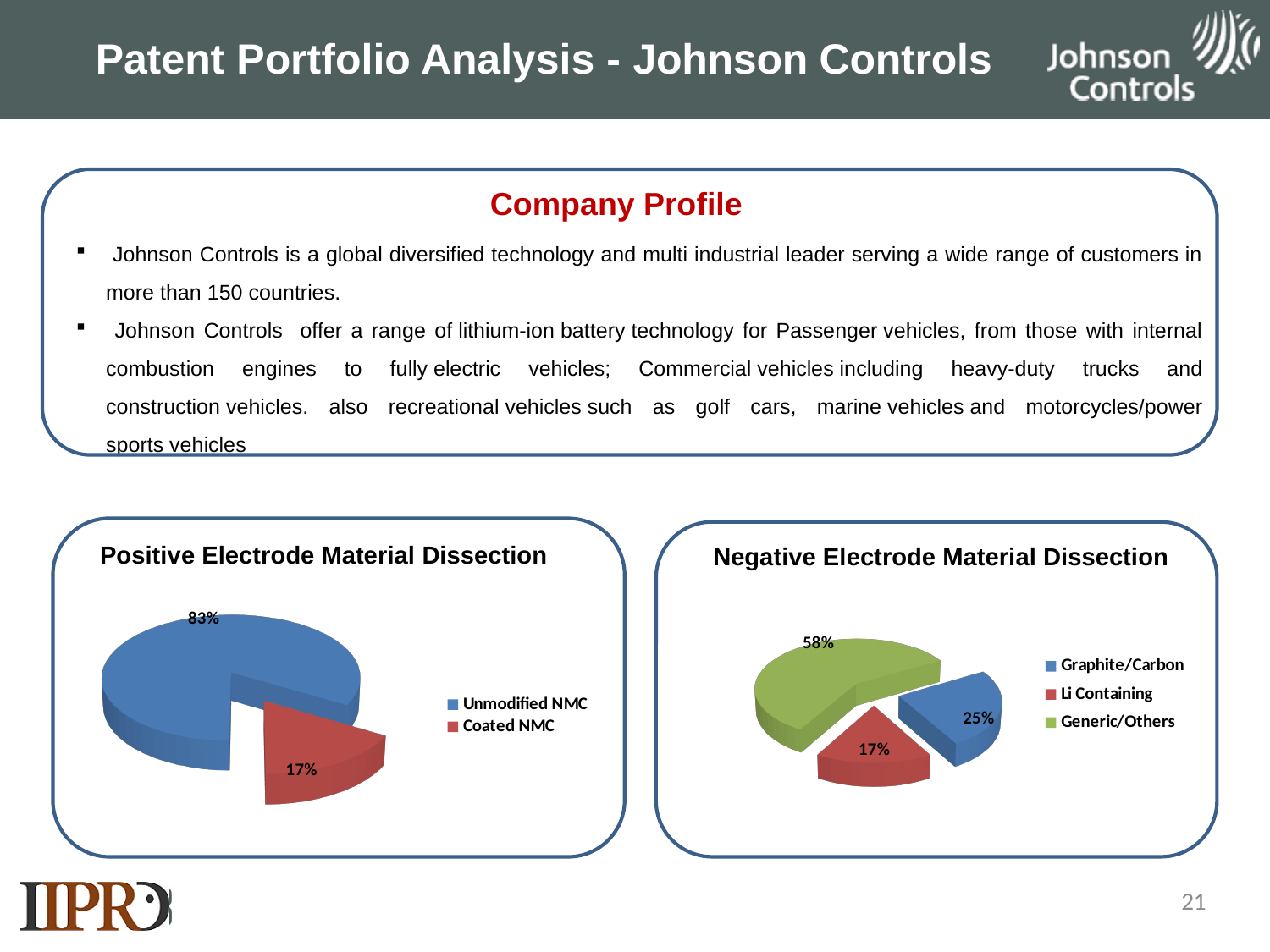
In the Positive Electrode Material Dissection chart, what share does Coated NMC have? 17% How many categories does the Negative Electrode Material Dissection chart show? 3 In the Negative Electrode Material Dissection chart, which category has the largest share? Generic/Others In the Positive Electrode Material Dissection chart, what is the difference in percentage points between Unmodified NMC and Coated NMC? 66 In the Positive Electrode Material Dissection chart, what colour represents Coated NMC? Red In the Negative Electrode Material Dissection chart, what share does Generic/Others have? 58% In the Negative Electrode Material Dissection chart, which is larger: Graphite/Carbon or Li Containing? Graphite/Carbon In the Negative Electrode Material Dissection chart, which category has the smallest share? Li Containing In the Negative Electrode Material Dissection chart, what share does Graphite/Carbon have? 25% In the Negative Electrode Material Dissection chart, what share does Li Containing have? 17% In the Positive Electrode Material Dissection chart, what share does Unmodified NMC have? 83% What kind of chart is the Positive Electrode Material Dissection chart? Pie chart